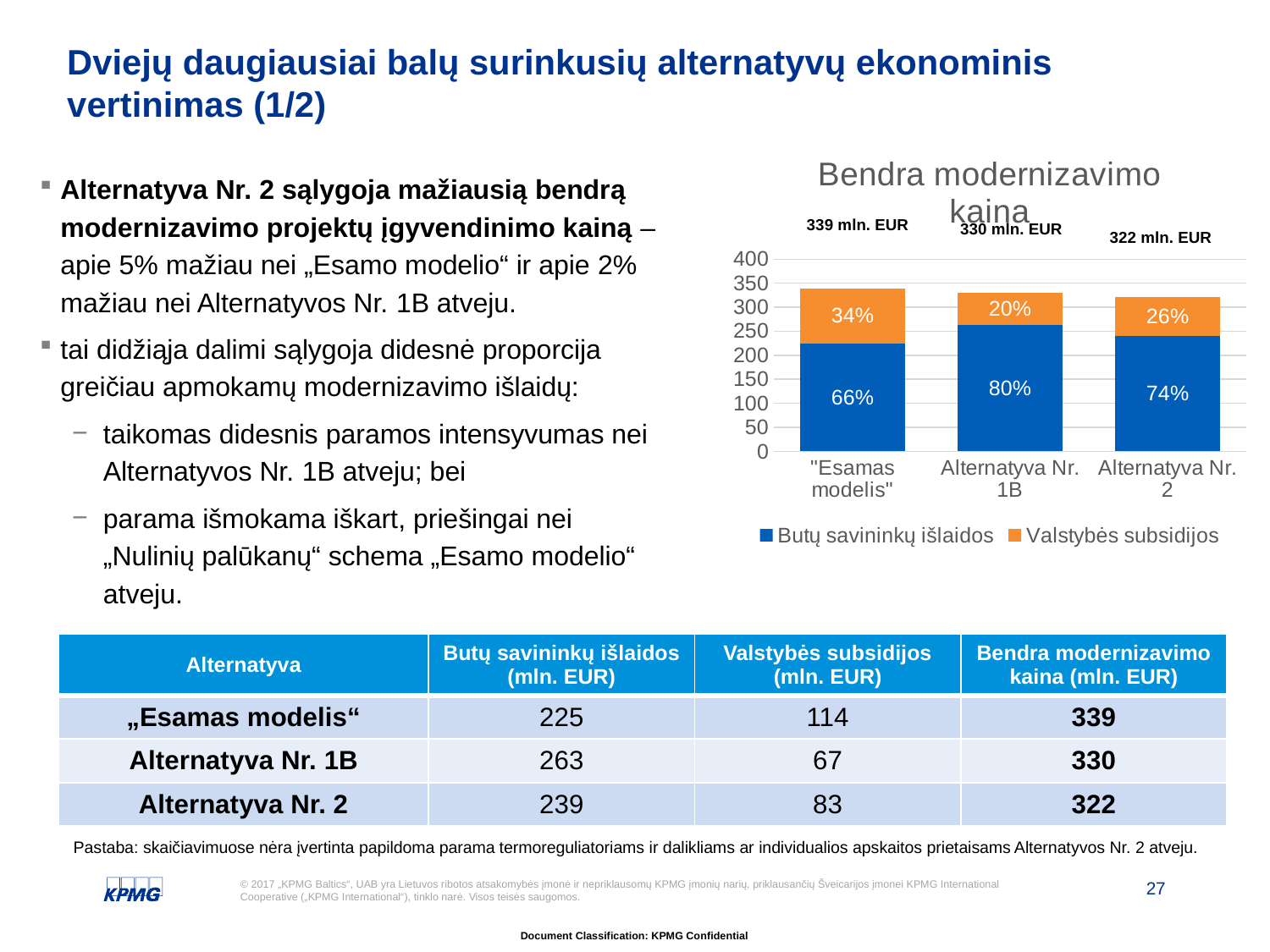
What percentage label is shown for Valstybės subsidijos in the "Esamas modelis" bar? 34% What total is printed above the bar for Alternatyva Nr. 2? 322 mln. EUR What total is printed above the bar for "Esamas modelis"? 339 mln. EUR How many categories are shown on the x axis of the chart? 3 What percentage label is shown for Butų savininkų išlaidos in the Alternatyva Nr. 1B bar? 80% Which category has the highest total modernisation cost printed above its bar? "Esamas modelis" What kind of chart is shown on the slide? Stacked bar chart What is the title of the chart? Bendra modernizavimo kaina How many series does the chart legend list? 2 Which category has the lowest total modernisation cost printed above its bar? Alternatyva Nr. 2 Do the totals printed above the bars rise or fall from left to right along the x axis? Fall What is the difference between the totals printed for "Esamas modelis" and Alternatyva Nr. 2? 17 mln. EUR